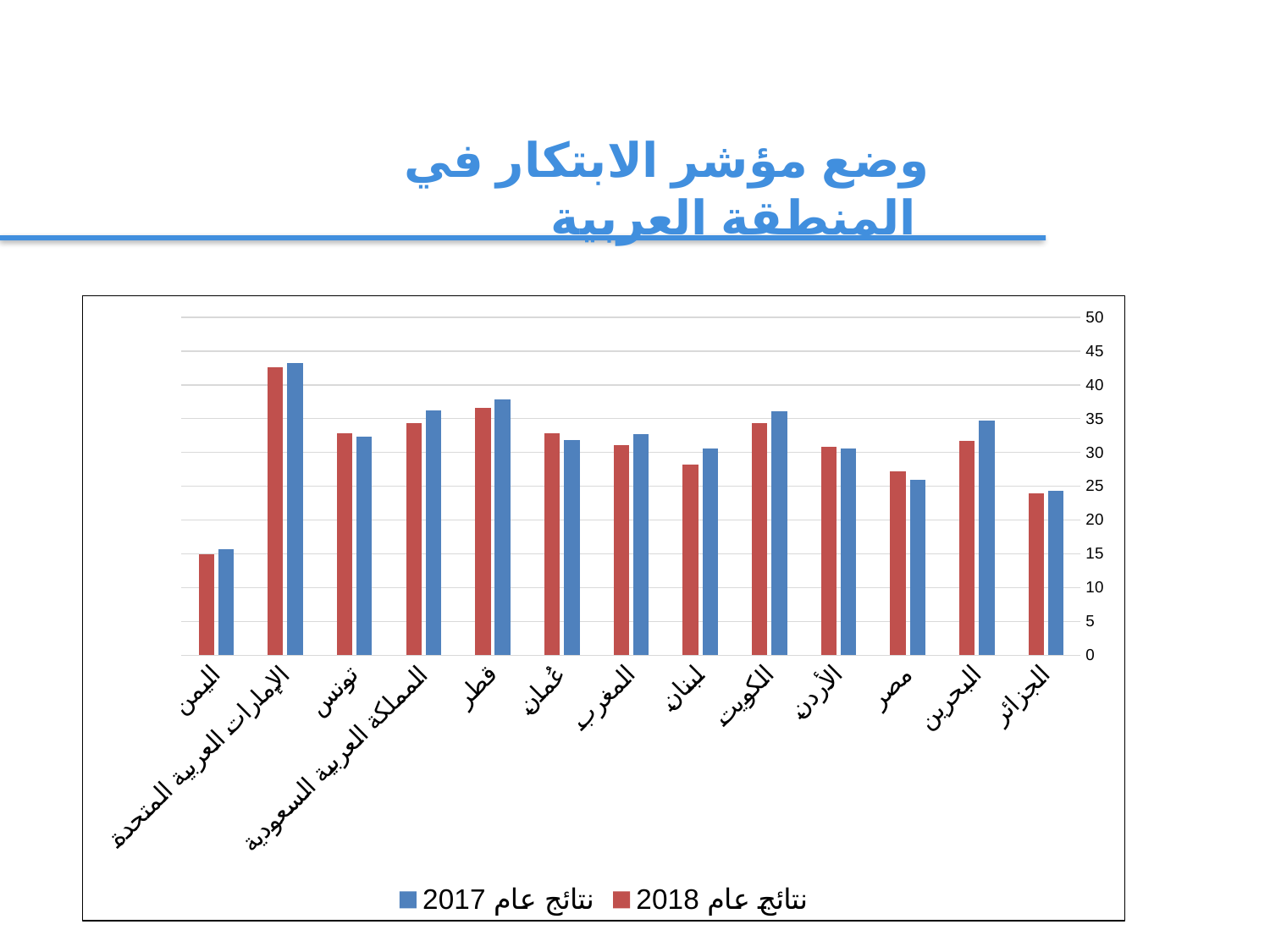
For المملكة العربية السعودية, which series has the larger value: نتائج عام 2018 or نتائج عام 2017? نتائج عام 2017 Which country has the lowest value for نتائج عام 2017? اليمن Is the value for لبنان in نتائج عام 2018 greater or less than 30? less For نتائج عام 2018, which country has the larger value: قطر or الكويت? قطر Is the value for اليمن in نتائج عام 2018 greater or less than 20? less Which colour represents the series نتائج عام 2018 in the chart? red Which country has the highest value for نتائج عام 2018? الإمارات العربية المتحدة How many series does the chart legend list? 2 Is the value for الإمارات العربية المتحدة in نتائج عام 2017 greater or less than 40? greater How many countries (categories) are shown on the x axis of the chart? 13 What type of chart is shown on the slide? bar chart